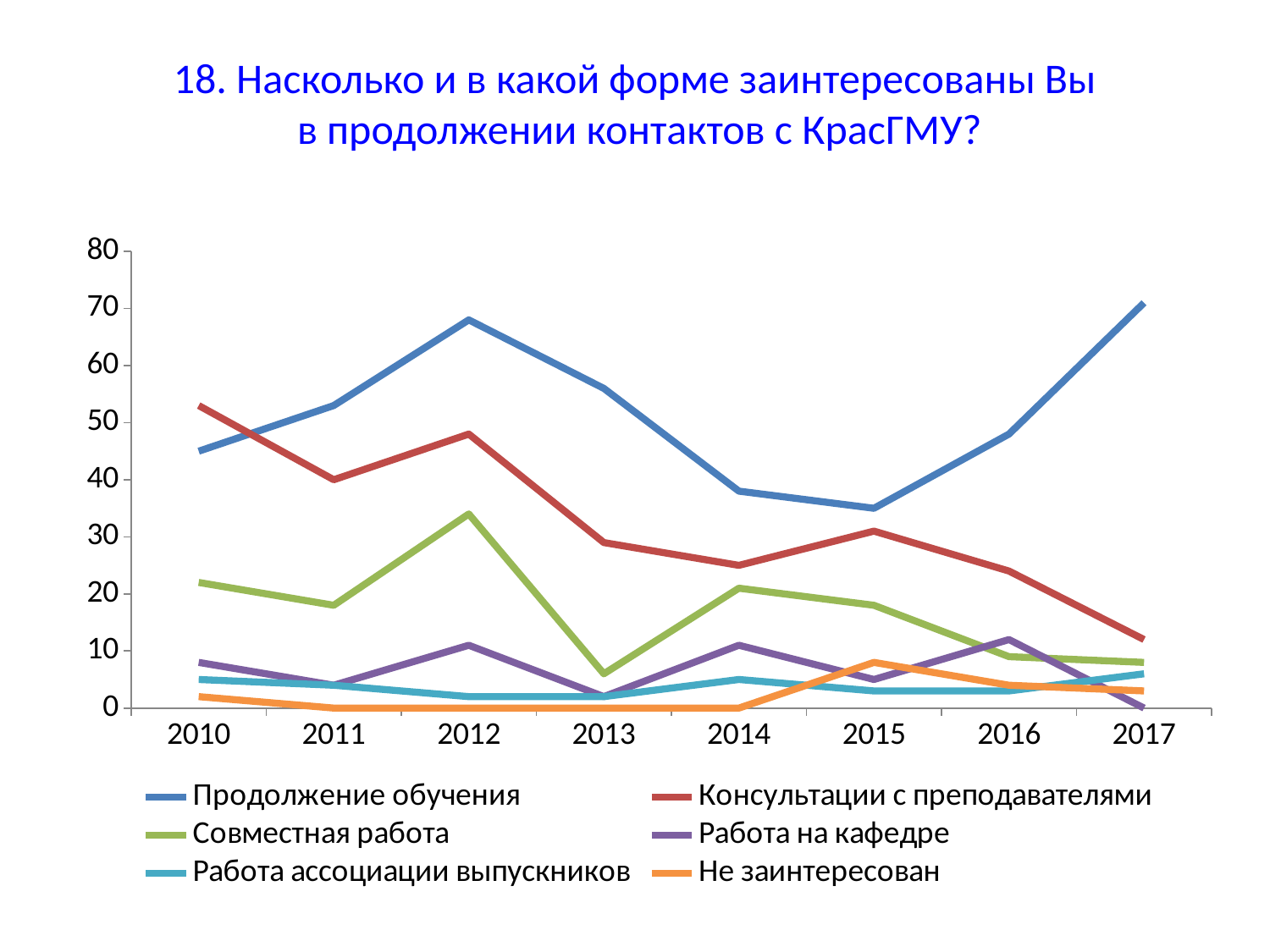
Does the "Консультации с преподавателями" series rise or fall from 2015 to 2017? fall How many years are shown along the x axis? 8 Which series has the larger value in 2010: "Продолжение обучения" or "Консультации с преподавателями"? Консультации с преподавателями What is the value of the "Не заинтересован" series in 2013? 0 How many series does the legend list? 6 Is the value for "Консультации с преподавателями" in 2017 greater or less than 20? less In which year does the "Продолжение обучения" series reach its lowest value? 2015 In which year does the "Продолжение обучения" series reach its highest value? 2017 What kind of chart is shown on the slide? line chart Is the value for "Продолжение обучения" in 2017 greater or less than 60? greater In which year does the "Консультации с преподавателями" series reach its highest value? 2010 In which year does the "Совместная работа" series reach its highest value? 2012